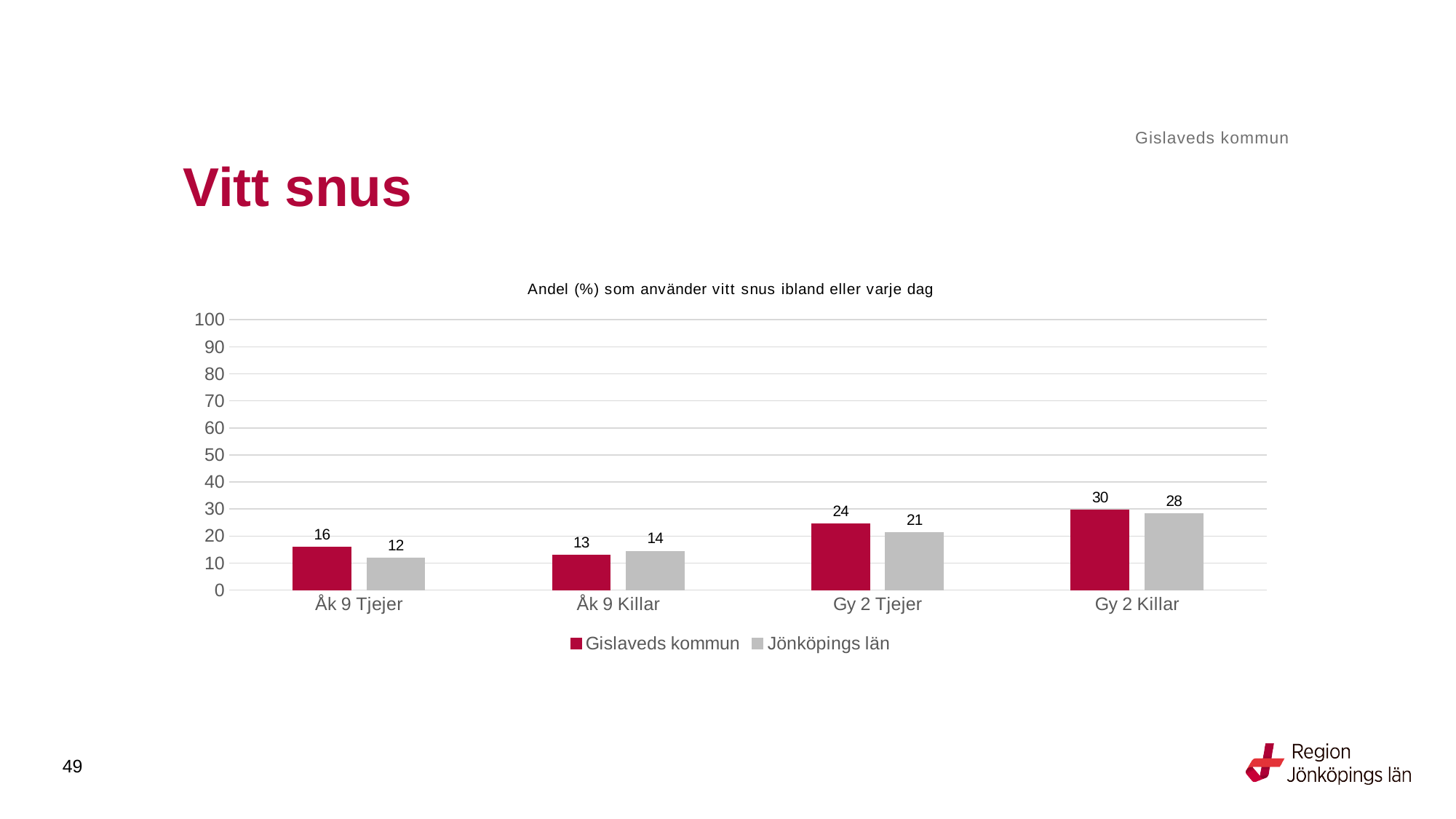
What kind of chart is shown on the slide? Bar chart Which category has the highest value for Gislaveds kommun? Gy 2 Killar What is the value for Jönköpings län for Åk 9 Killar? 14 Which is larger for Åk 9 Killar: Gislaveds kommun or Jönköpings län? Jönköpings län How many categories are shown on the x axis? 4 Is the value for Gislaveds kommun for Gy 2 Killar greater or less than 20? greater What is the difference between Gislaveds kommun and Jönköpings län for Gy 2 Tjejer? 3 How many series does the legend list? 2 Which category has the lowest value for Jönköpings län? Åk 9 Tjejer What is the title of the chart? Andel (%) som använder vitt snus ibland eller varje dag What is the value for Jönköpings län for Gy 2 Tjejer? 21 What is the value for Gislaveds kommun for Åk 9 Tjejer? 16